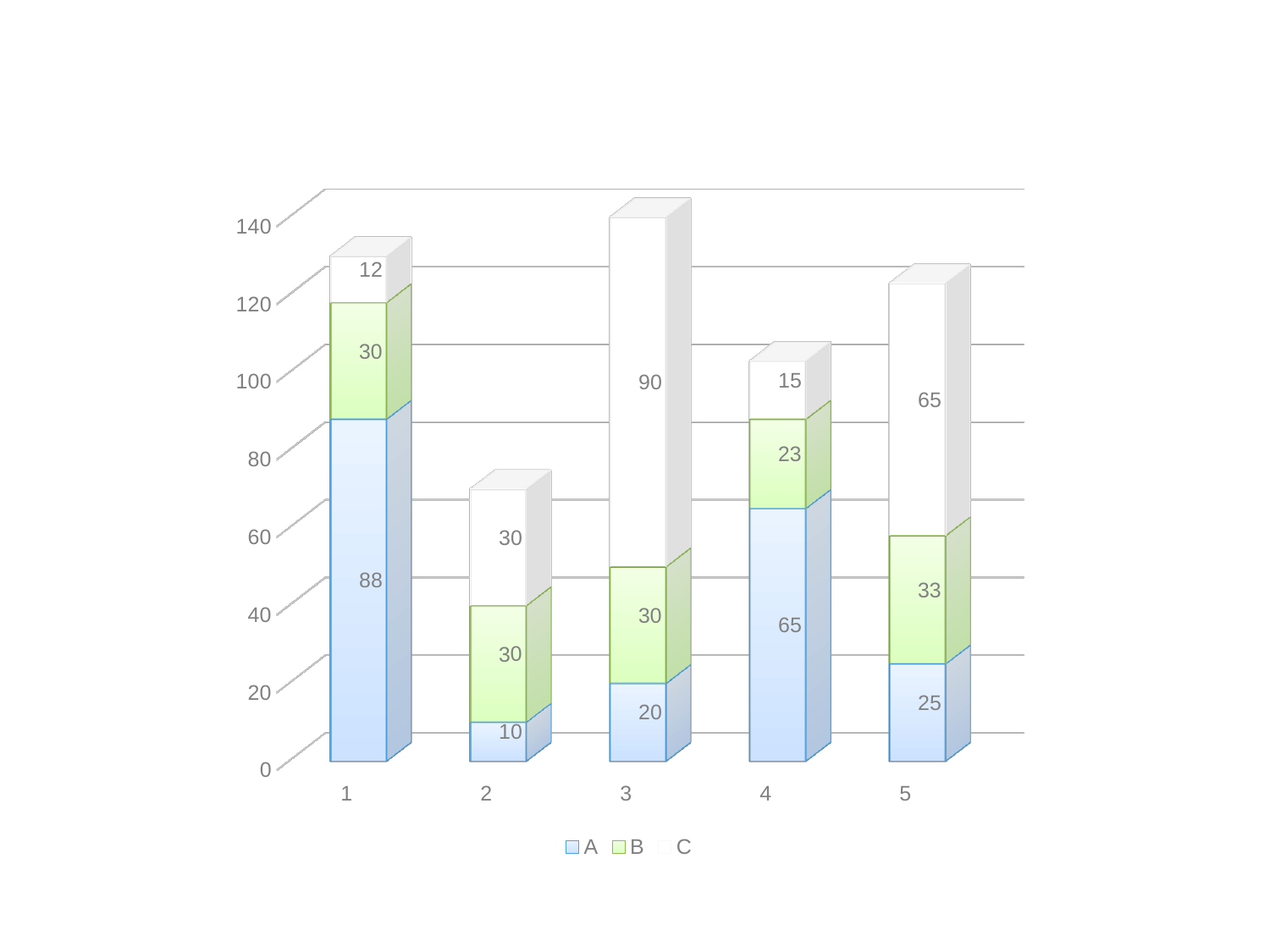
Which category has the highest value for series A? 1 How many series does the legend list? 3 Which is larger: series C for category 5 or series C for category 2? series C for category 5 What is the value of series B for category 5? 33 How many categories are shown on the x axis? 5 What is the value of series C for category 3? 90 What is the total of the stacked bar for category 2? 70 What is the value of series A for category 1? 88 What is the difference between the series A values for category 1 and category 4? 23 What kind of chart is shown on the slide? stacked bar chart Which category has the lowest value for series A? 2 What is the total of the stacked bar for category 4? 103